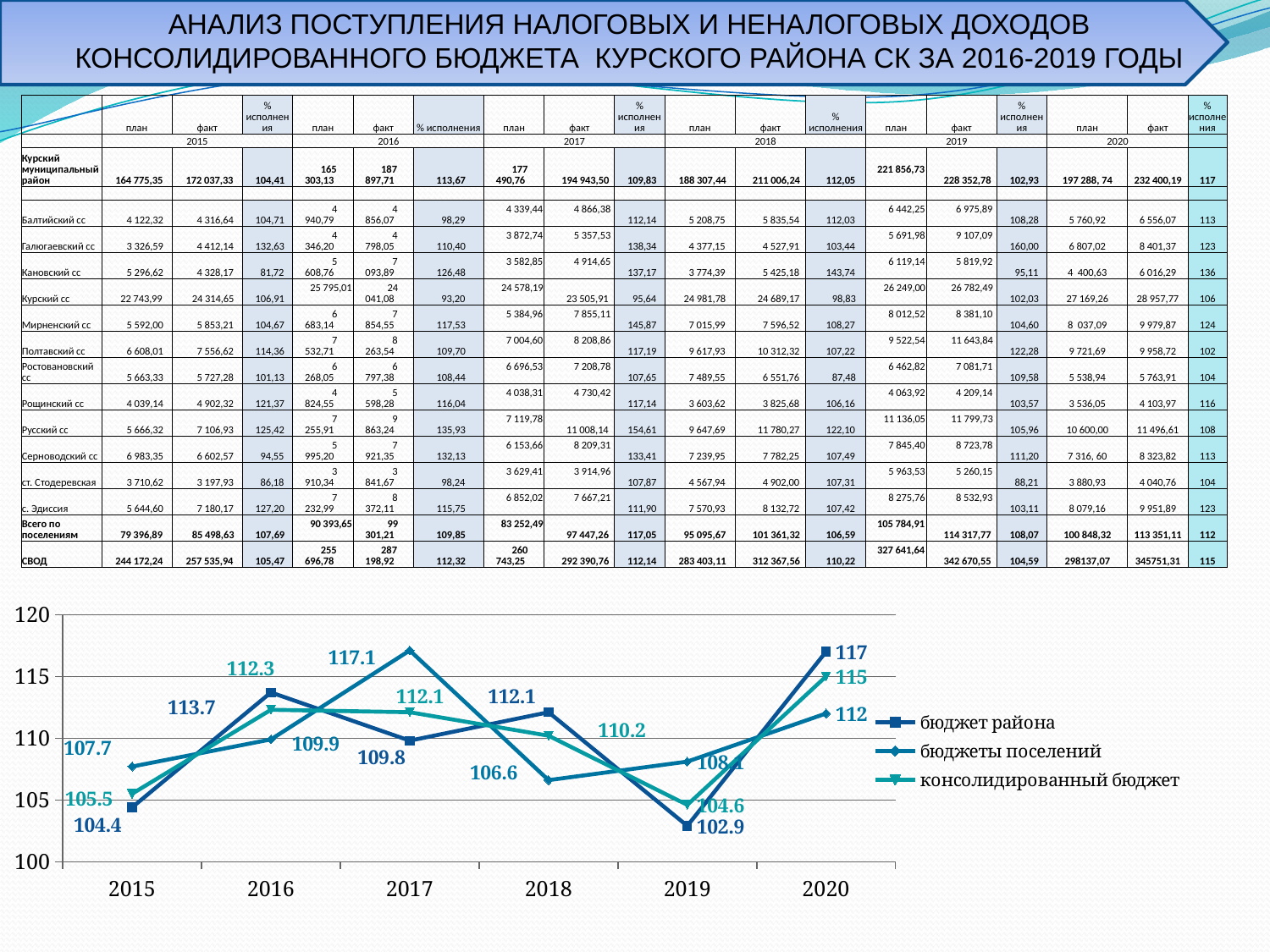
In the line chart, in which year is the value for бюджет района the lowest? 2019 How many series does the legend of the line chart list? 3 In the line chart, what is the value for бюджет района in 2016? 113.7 In the line chart, which series has the larger value in 2015: бюджет района or бюджеты поселений? бюджеты поселений In the line chart, which series is drawn with square markers? бюджет района In the line chart, in which year is the value for бюджет района the highest? 2020 In the line chart, what is the difference between the бюджет района values in 2020 and 2019? 14.1 In the line chart, what is the value for консолидированный бюджет in 2020? 115 In the line chart, what is the value for бюджеты поселений in 2017? 117.1 What kind of chart is shown at the bottom of the slide? line chart In the line chart, does the value for бюджет района fall or rise from 2019 to 2020? rise How many years are shown on the x axis of the line chart? 6